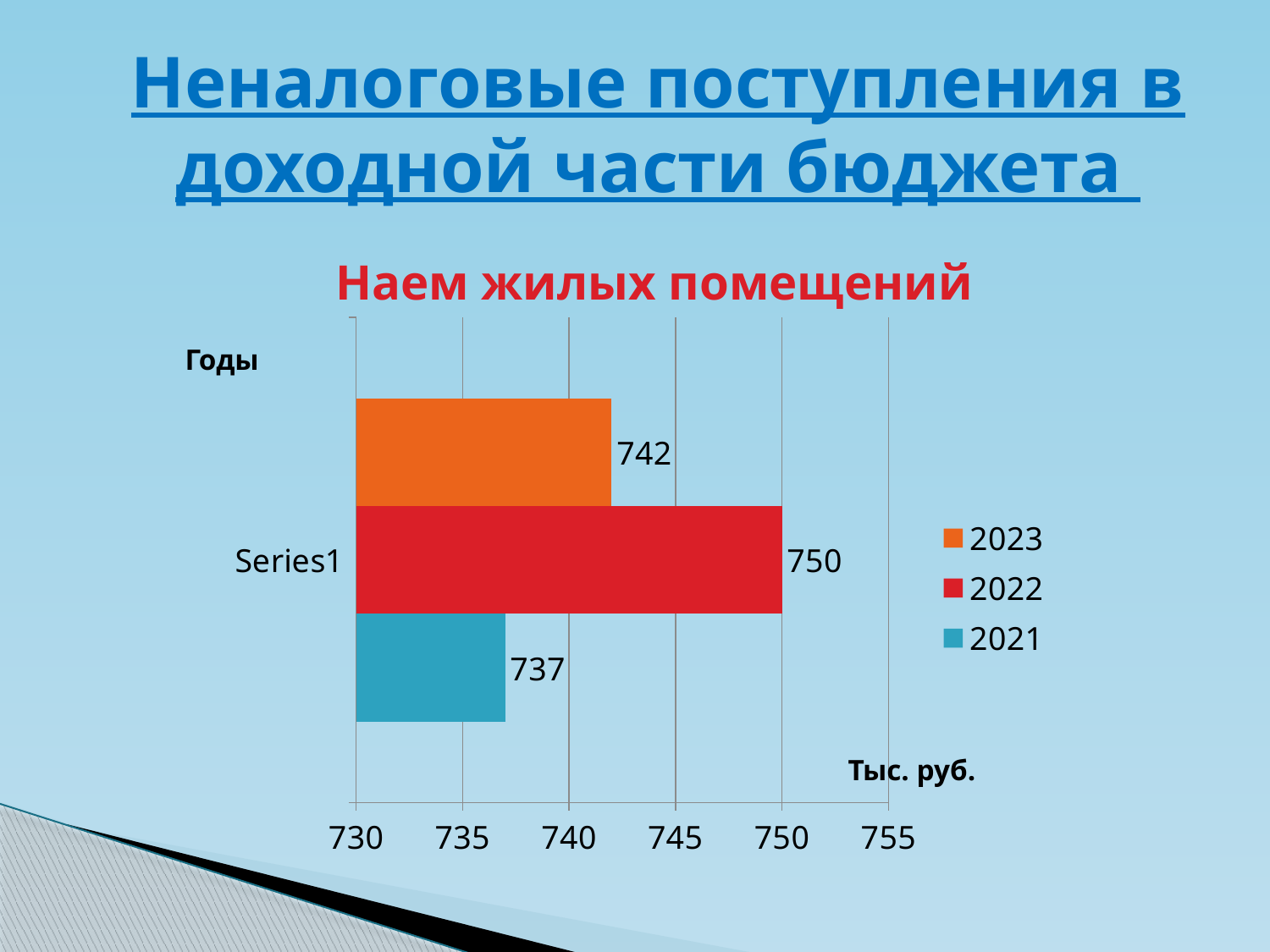
Which year has the lowest value? 2021 What is the value for 2023 in the chart? 742 What is the value for 2022 in the chart? 750 Which year has the highest value? 2022 What is the difference between the values for 2023 and 2021? 5 Which is larger, the value for 2023 or the value for 2021? 2023 What kind of chart is shown on the slide? bar chart What is the value for 2021 in the chart? 737 What is the title of the chart? Наем жилых помещений Is the value for 2022 greater or less than 745? greater How many series does the legend list? 3 What is the difference between the values for 2022 and 2021? 13